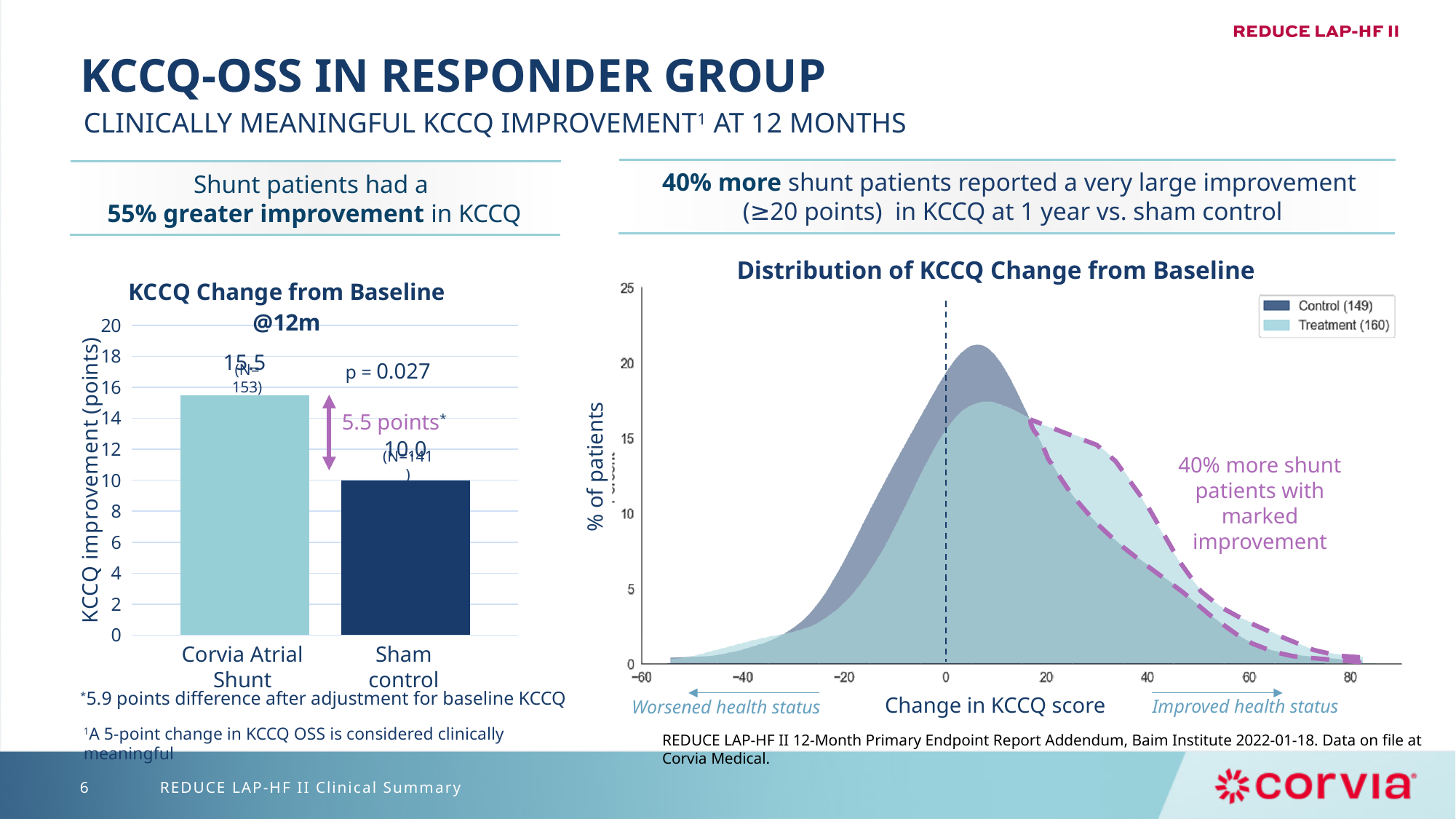
What kind of chart is 'KCCQ Change from Baseline @12m'? Bar chart In the 'Distribution of KCCQ Change from Baseline' chart, how many series does the legend list? 2 In the 'KCCQ Change from Baseline @12m' chart, is the value for Sham control greater or less than 12? less In the 'KCCQ Change from Baseline @12m' chart, which category has the higher value? Corvia Atrial Shunt In the 'KCCQ Change from Baseline @12m' chart, how many categories are shown? 2 In the 'KCCQ Change from Baseline @12m' chart, what is the difference between the Corvia Atrial Shunt and Sham control values? 5.5 points In the 'KCCQ Change from Baseline @12m' chart, which category has the lowest value? Sham control In the 'Distribution of KCCQ Change from Baseline' chart, what are the two legend entries? Control (149) and Treatment (160) In the 'KCCQ Change from Baseline @12m' chart, what is the value for Sham control? 10.0 In the 'Distribution of KCCQ Change from Baseline' chart, what is the label of the y axis? % of patients In the 'KCCQ Change from Baseline @12m' chart, what is the value for Corvia Atrial Shunt? 15.5 In the 'KCCQ Change from Baseline @12m' chart, what p-value is shown? p = 0.027